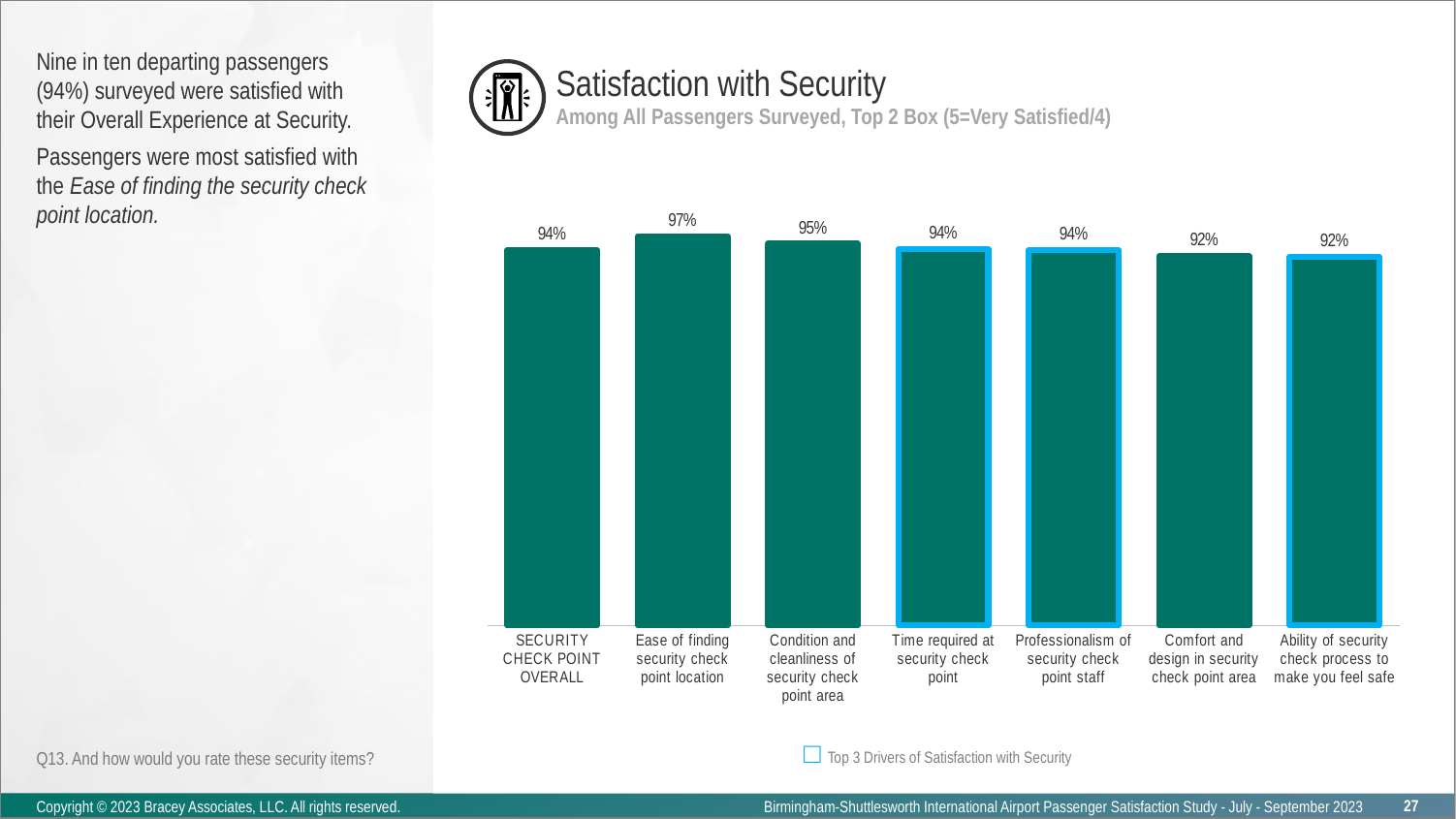
What is the lowest value shown in the chart? 92% What is the value for Comfort and design in security check point area? 92% What is the value for Condition and cleanliness of security check point area? 95% Which category has the highest value? Ease of finding security check point location What kind of chart is shown on the slide? Bar chart How many categories are shown in the chart? 7 What is the difference between Ease of finding security check point location and Ability of security check process to make you feel safe? 5 percentage points Which is larger: Condition and cleanliness of security check point area or Professionalism of security check point staff? Condition and cleanliness of security check point area What is the value for SECURITY CHECK POINT OVERALL? 94% What is the title of the chart? Satisfaction with Security How many bars are outlined as Top 3 Drivers of Satisfaction with Security? 3 What is the value for Ease of finding security check point location? 97%